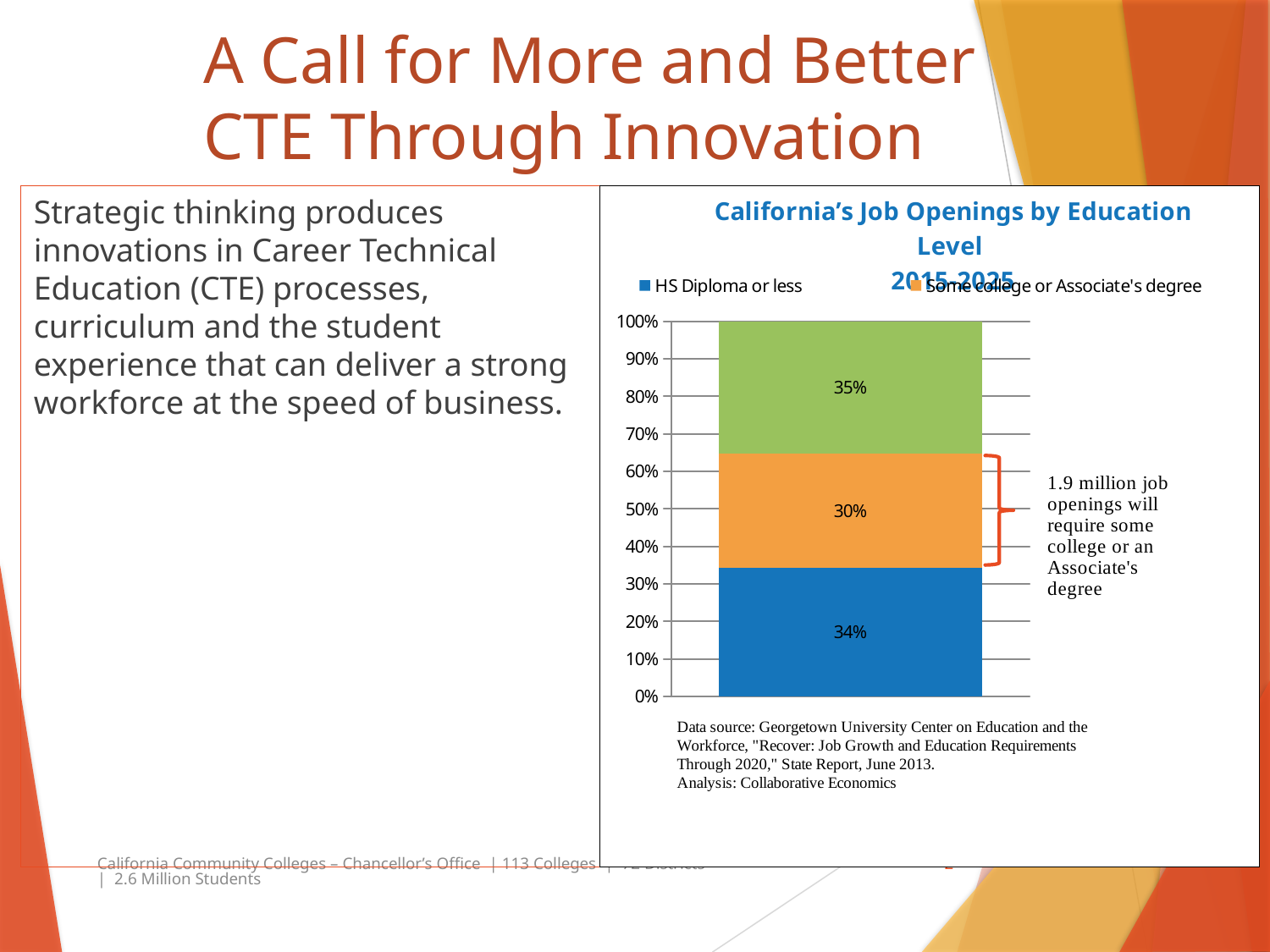
What kind of chart is shown on the slide? Stacked bar chart Which is larger: the share for 'HS Diploma or less' or for 'Some college or Associate's degree'? HS Diploma or less According to the annotation next to the chart, how many job openings will require some college or an Associate's degree? 1.9 million What percentage of job openings are for 'Some college or Associate's degree'? 30% Is the value for 'HS Diploma or less' greater or less than 30%? greater What percentage of California's job openings are for 'HS Diploma or less'? 34% Which education level segment has the smallest share of job openings? Some college or Associate's degree What value is labelled on the top (green) segment of the stacked bar? 35% What is the total of the three labelled segments in the stacked bar? 99% What is the difference in percentage points between 'HS Diploma or less' and 'Some college or Associate's degree'? 4 percentage points What colour is the 'HS Diploma or less' segment of the bar? Blue How many segments make up the stacked bar? 3